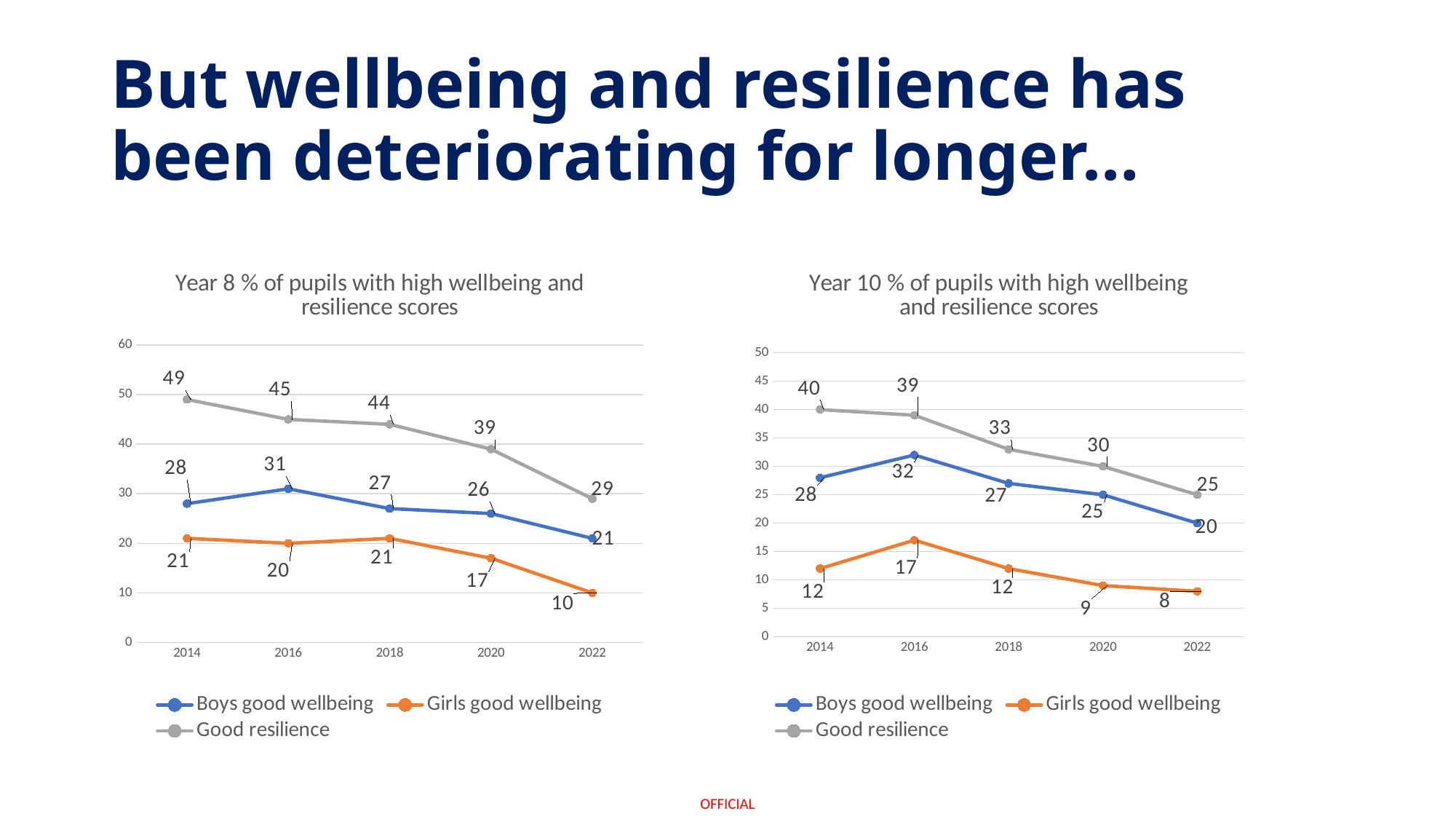
In the Year 10 chart, what is the value for Girls good wellbeing in 2016? 17 In the Year 10 chart, which is larger in 2018: Good resilience or Boys good wellbeing? Good resilience In the Year 8 chart, what is the difference between Good resilience in 2014 and in 2022? 20 In the Year 10 chart, in which year is Boys good wellbeing highest? 2016 In the Year 8 chart, in which year is Girls good wellbeing lowest? 2022 What kind of chart is the Year 8 chart? Line chart In the Year 8 chart, what is the value for Boys good wellbeing in 2022? 21 In the Year 10 chart, what is the difference between Boys good wellbeing and Girls good wellbeing in 2022? 12 How many years are plotted on the x axis of the Year 8 chart? 5 In the Year 8 chart, does Good resilience rise or fall from 2014 to 2022? Fall How many series does the legend of the Year 10 chart list? 3 In the Year 8 chart, what is the value for Good resilience in 2014? 49